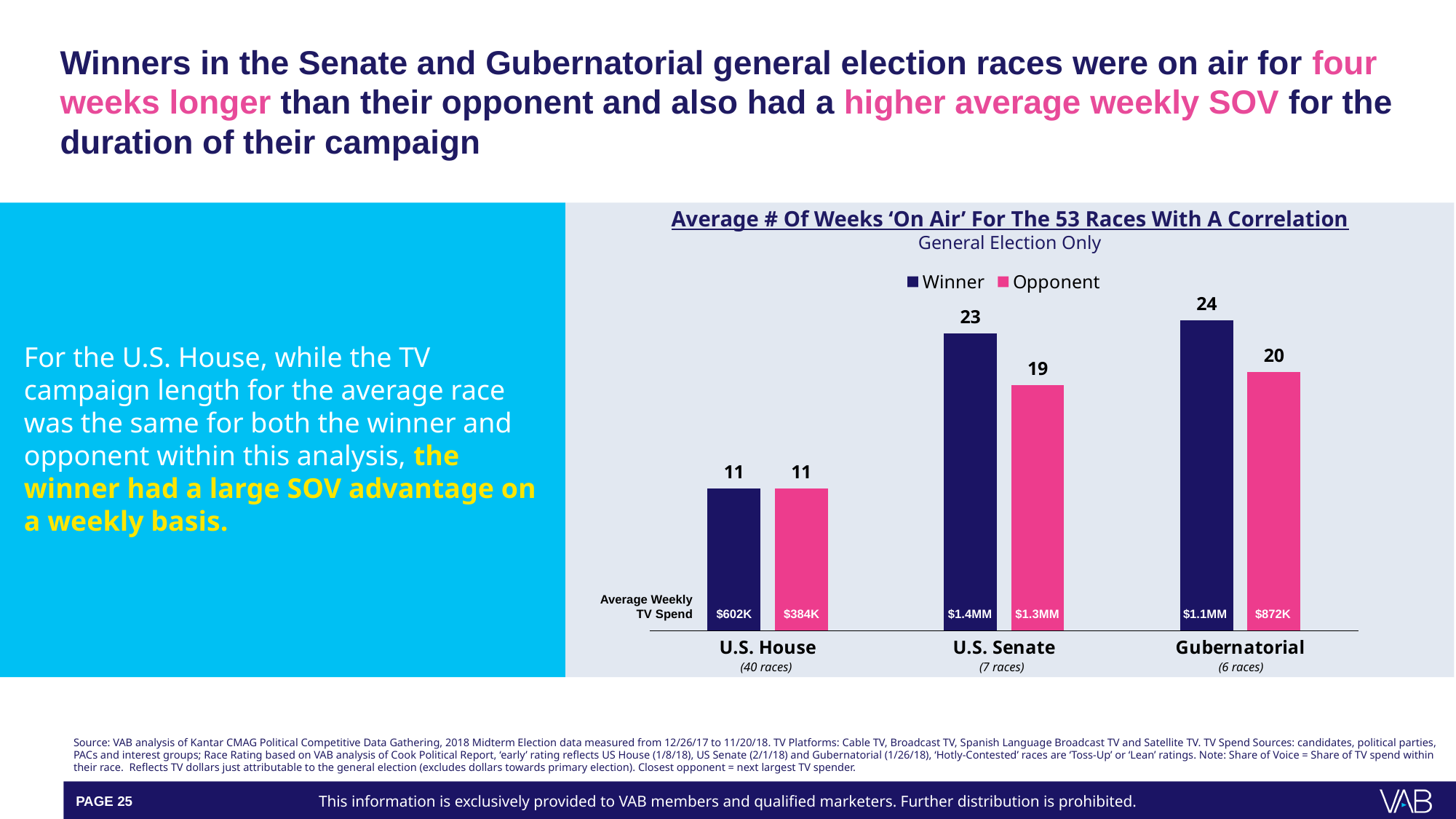
What kind of chart is shown on the slide? Bar chart Which category has the highest Winner value for average weeks on air? Gubernatorial What is the average number of weeks on air for the Winner in U.S. House races? 11 Which category has the lowest Opponent value for average weeks on air? U.S. House What is the average number of weeks on air for the Winner in U.S. Senate races? 23 What is the difference between the Winner and Opponent average weeks on air in Gubernatorial races? 4 What is the average weekly TV spend shown for the Winner in U.S. House races? $602K What is the difference between the Winner and Opponent average weeks on air in U.S. Senate races? 4 How many series does the chart legend list? 2 Which is larger, the Winner value for U.S. Senate or the Opponent value for Gubernatorial? Winner value for U.S. Senate What is the average number of weeks on air for the Opponent in Gubernatorial races? 20 How many race categories are shown on the x axis of the chart? 3